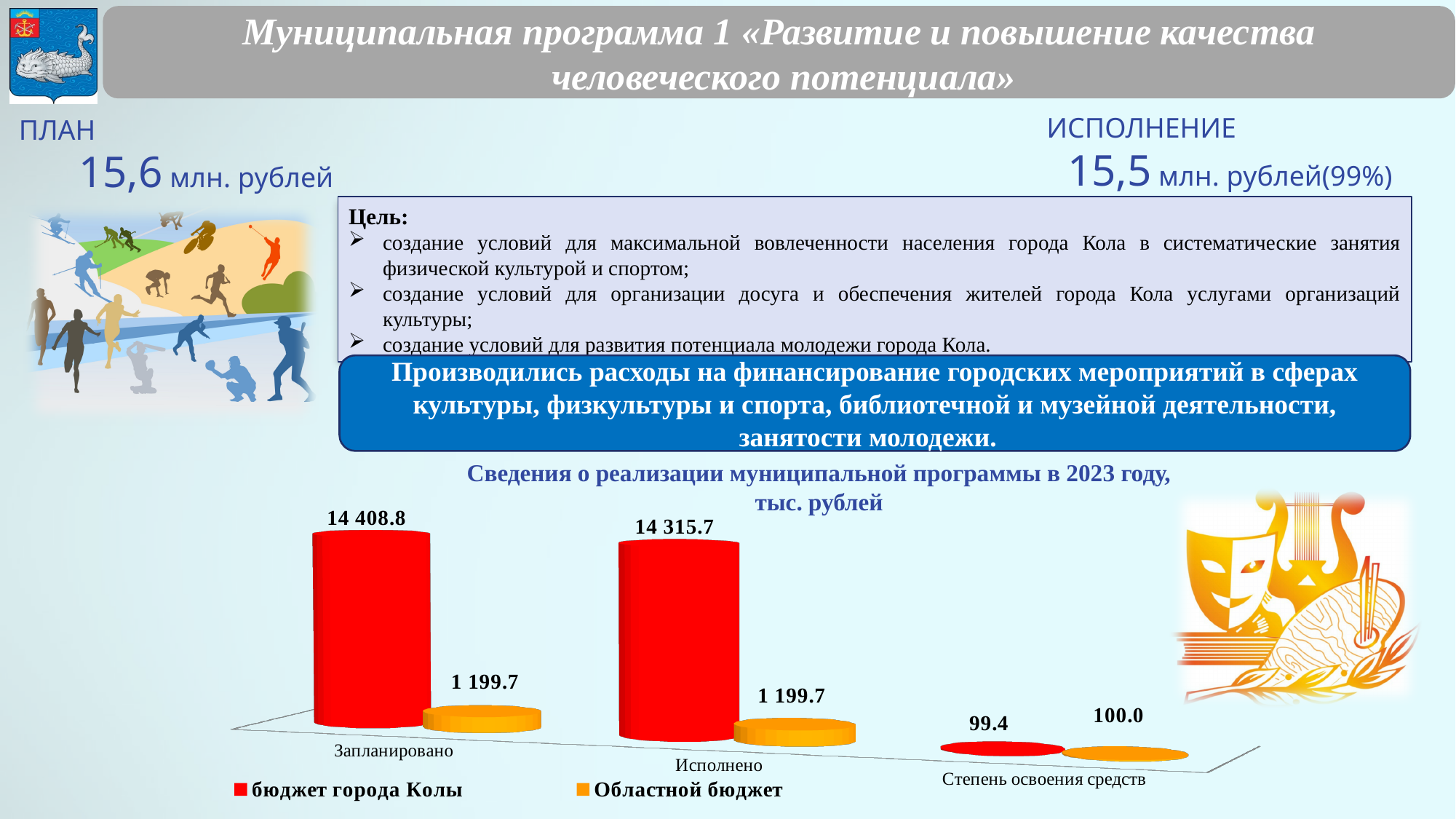
Which category has the highest value for бюджет города Колы? Запланировано How many categories are shown on the x axis of the chart? 3 What kind of chart is shown on the slide? Bar chart What is the title of the chart? Сведения о реализации муниципальной программы в 2023 году, тыс. рублей What is the value for бюджет города Колы in the Степень освоения средств category? 99.4 What is the value for Областной бюджет in the Степень освоения средств category? 100.0 Which category has the lowest value for бюджет города Колы? Степень освоения средств What is the value for бюджет города Колы in the Запланировано category? 14 408.8 How many series does the chart legend list? 2 In the Исполнено category, which series has the larger value: бюджет города Колы or Областной бюджет? бюджет города Колы What is the value for Областной бюджет in the Исполнено category? 1 199.7 What is the difference between the бюджет города Колы values for Запланировано and Исполнено? 93.1